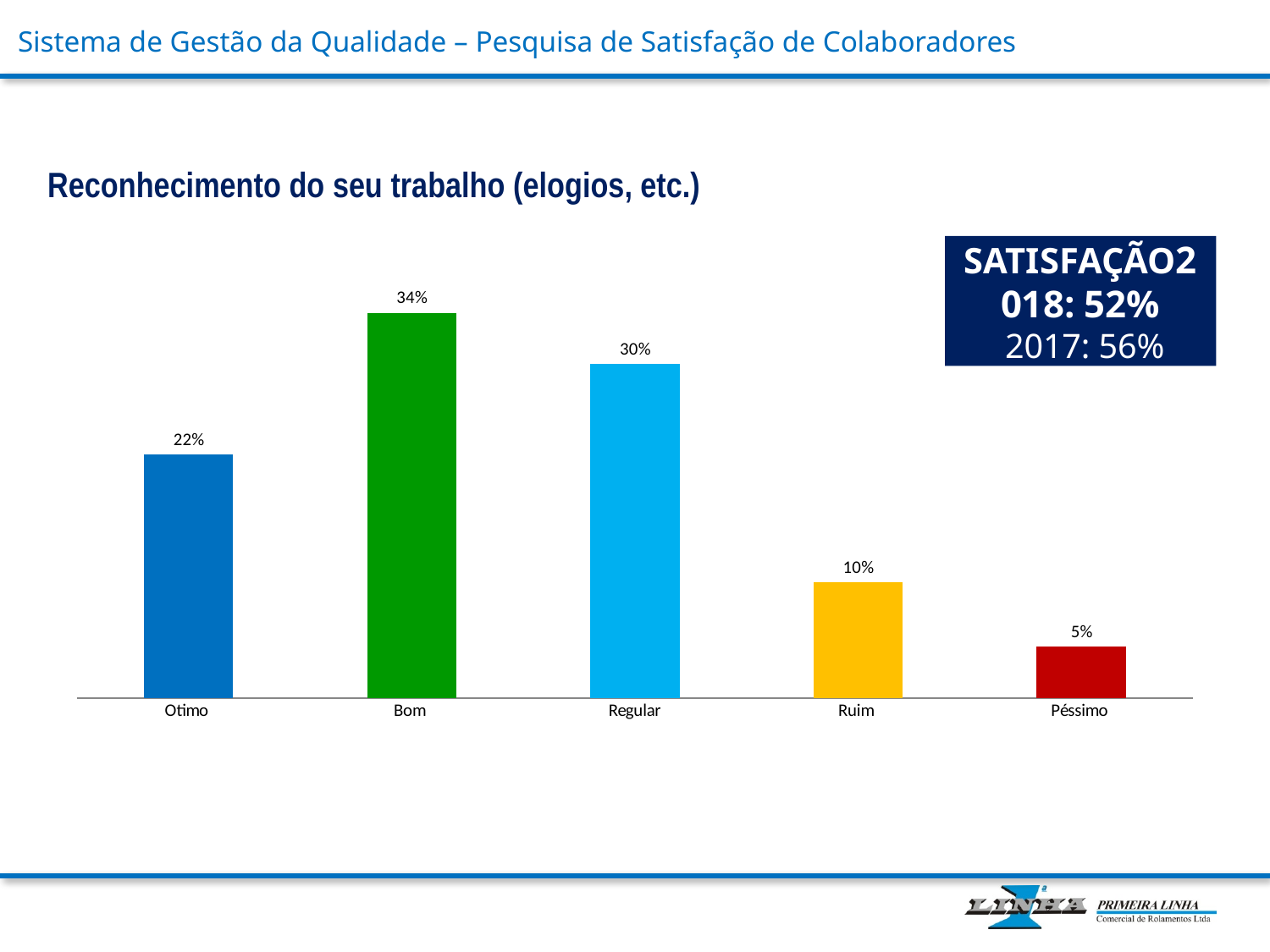
Which is larger, the value for Regular or the value for Otimo? Regular What is the difference between the values for Bom and Regular? 4% What is the title of the chart? Reconhecimento do seu trabalho (elogios, etc.) What is the value for Otimo? 22% What kind of chart is shown on the slide? Bar chart How many categories are shown on the x axis? 5 What is the value for Péssimo? 5% Which category has the highest value? Bom What is the value for Bom? 34% What colour is the bar for Ruim? Yellow Which category has the lowest value? Péssimo What is the difference between the values for Otimo and Ruim? 12%